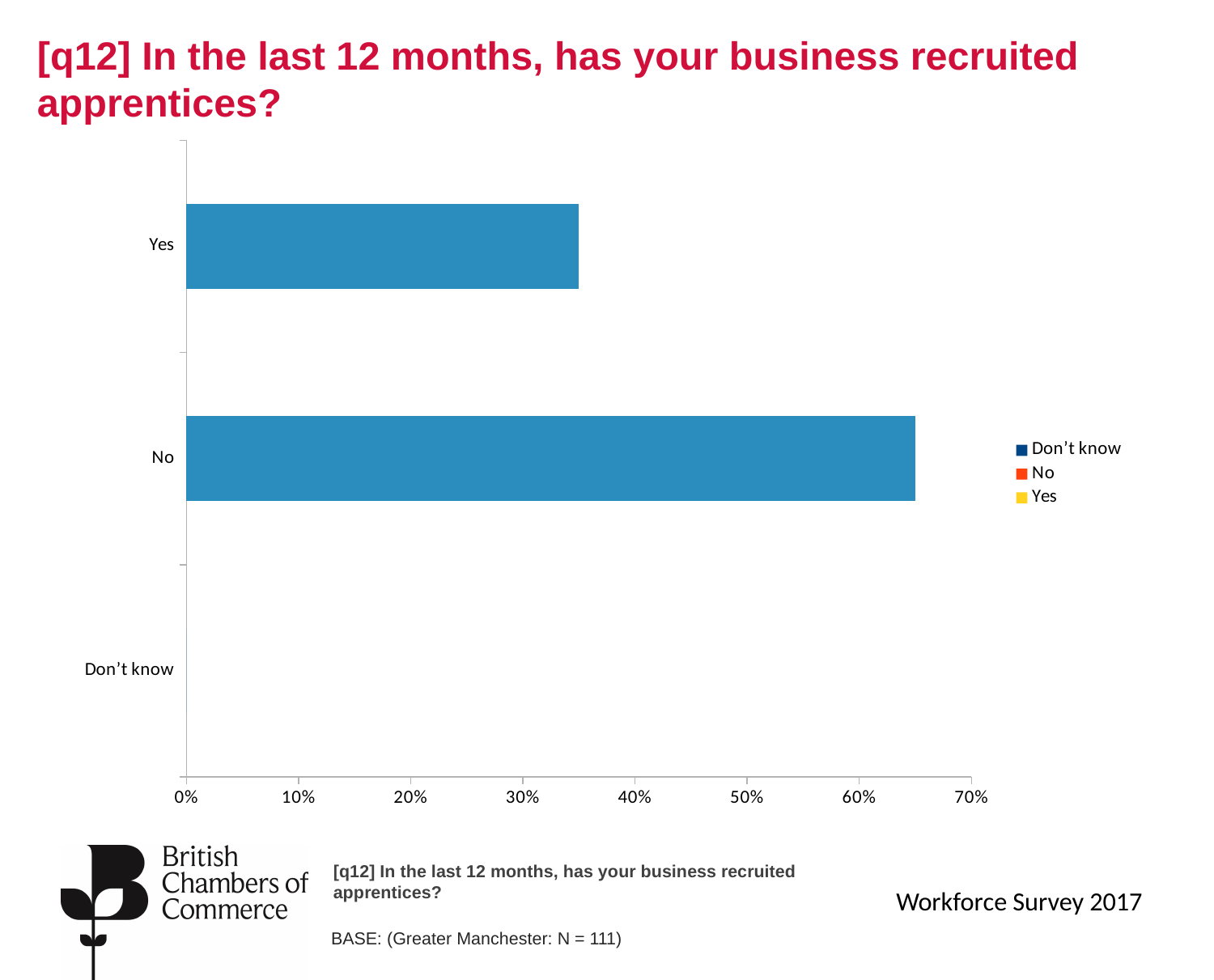
Is the value for No greater or less than 70%? less Which category has the smallest value? Don't know What is the highest value shown on the horizontal axis? 70% Which entry appears first in the chart's legend? Don't know What kind of chart is shown on the slide? Bar chart Which is larger, the value for Yes or the value for No? No How many entries does the chart's legend list? 3 Is the value for No greater or less than 60%? greater How many categories are shown on the vertical axis of the chart? 3 Is the value for Yes greater or less than 40%? less Which category has the longest bar? No